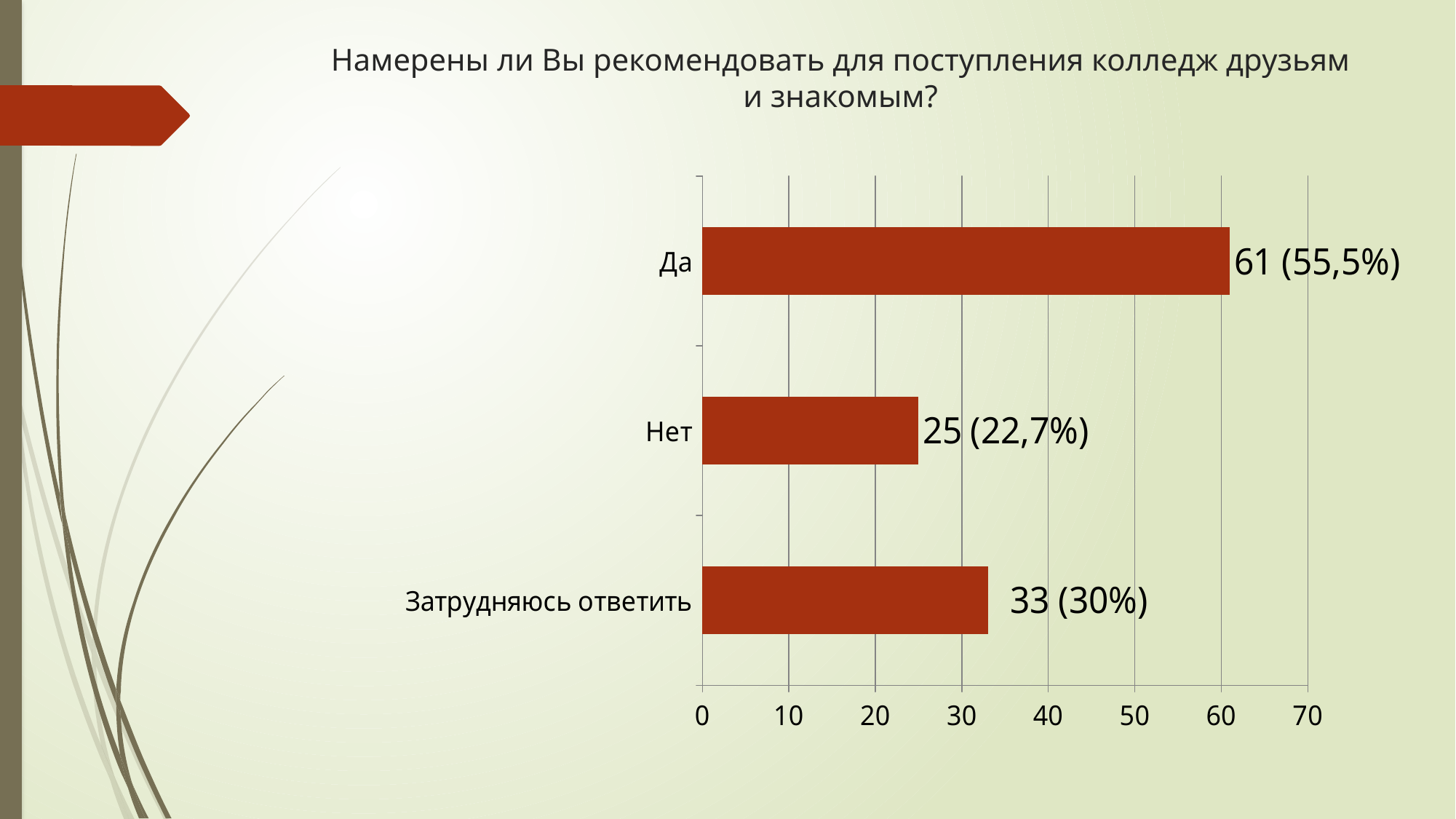
What is the value for "Нет"? 25 (22,7%) Which category has the lowest value? Нет What kind of chart is shown on the slide? bar chart What is the value for "Затрудняюсь ответить"? 33 (30%) Which is larger, the value for "Нет" or the value for "Затрудняюсь ответить"? Затрудняюсь ответить Which category has the highest value? Да Is the value for "Да" greater or less than 50? greater What is the difference between the counts for "Затрудняюсь ответить" and "Нет"? 8 What is the difference between the counts for "Да" and "Нет"? 36 How many categories are shown in the chart? 3 What is the value for "Да"? 61 (55,5%) What is the title of the chart? Намерены ли Вы рекомендовать для поступления колледж друзьям и знакомым?